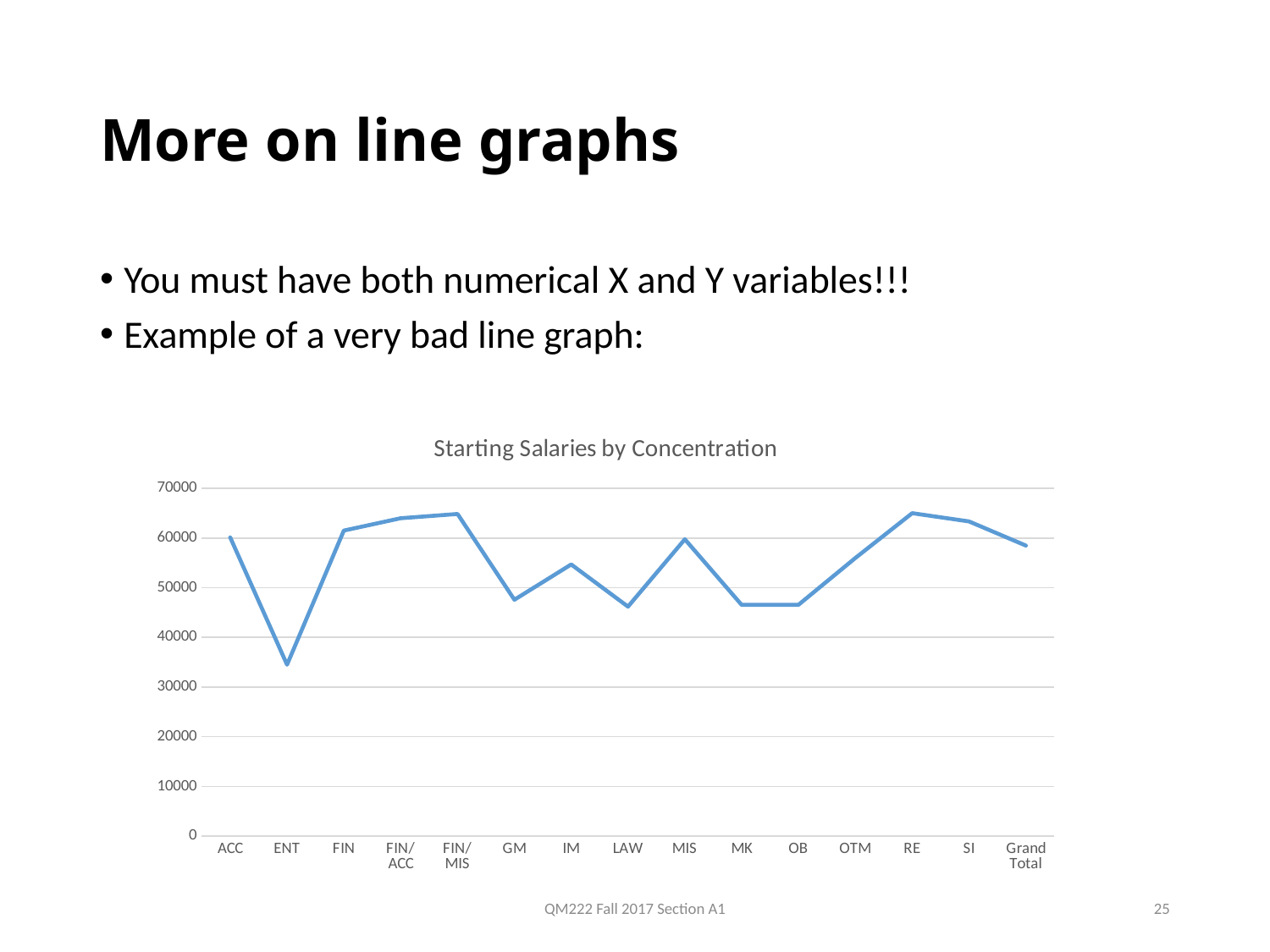
What is the title of the chart? Starting Salaries by Concentration Which concentration has the lowest starting salary in the chart? ENT Which has the larger value, LAW or IM? IM What kind of chart is shown on the slide? line chart Is the value for GM greater or less than 50000? less How many categories are plotted along the x axis of the chart? 15 Is the value for Grand Total greater or less than 50000? greater Does the line rise or fall from ACC to ENT? fall Is the value for ENT greater or less than 40000? less Which has the larger value, ENT or FIN? FIN